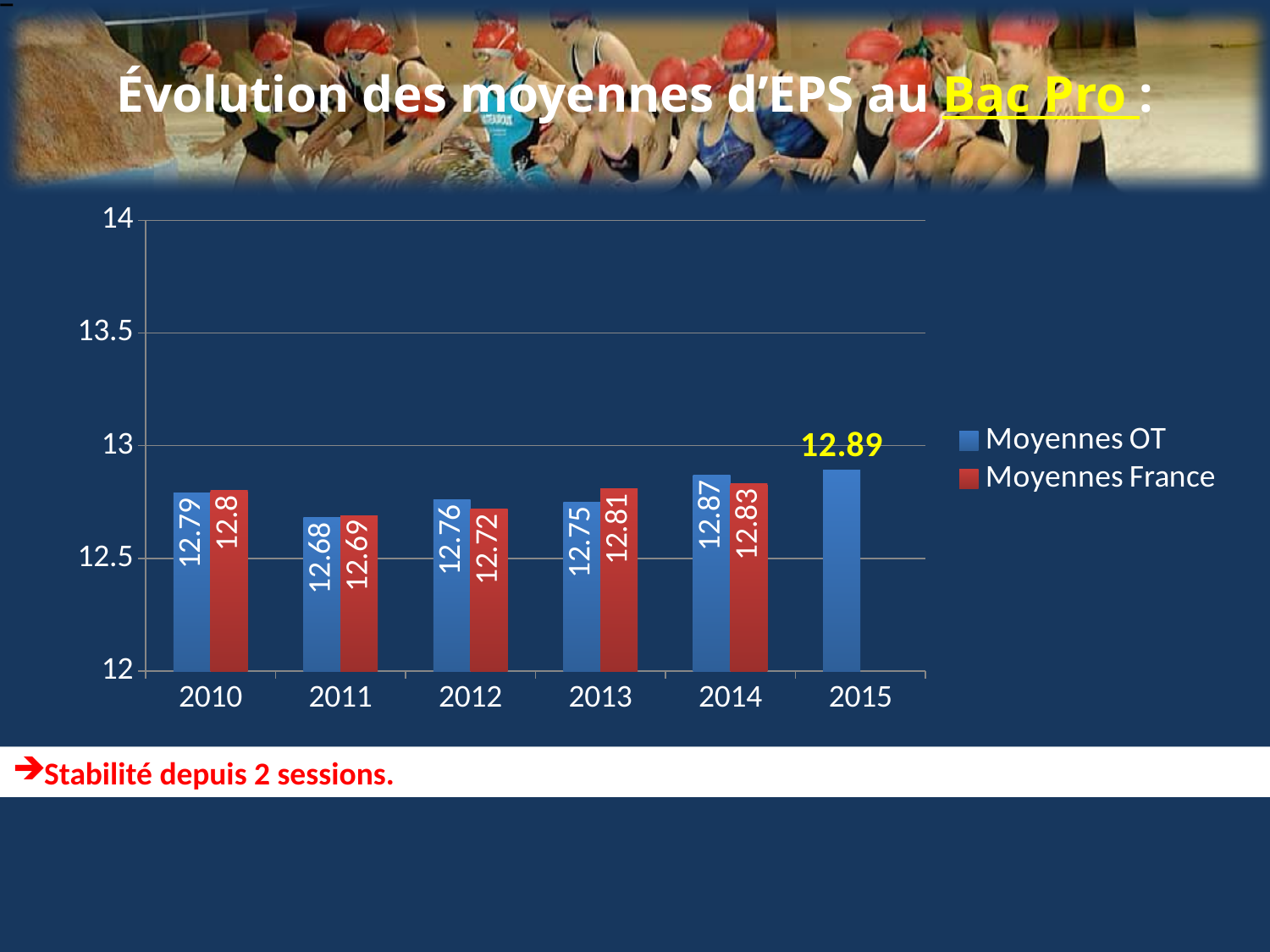
What is the value of Moyennes OT for 2011? 12.68 Which year has the lowest Moyennes France value? 2011 What is the value of Moyennes France for 2010? 12.8 What is the difference between Moyennes OT in 2015 and Moyennes OT in 2014? 0.02 Is the value of Moyennes OT for 2015 greater or less than 13? less What is the value of Moyennes France for 2013? 12.81 Which is larger in 2013, Moyennes OT or Moyennes France? Moyennes France What is the value of Moyennes OT for 2015? 12.89 What kind of chart is shown on the slide? Bar chart Which year has the highest Moyennes OT value? 2015 How many years are shown on the x axis? 6 How many series does the legend list? 2